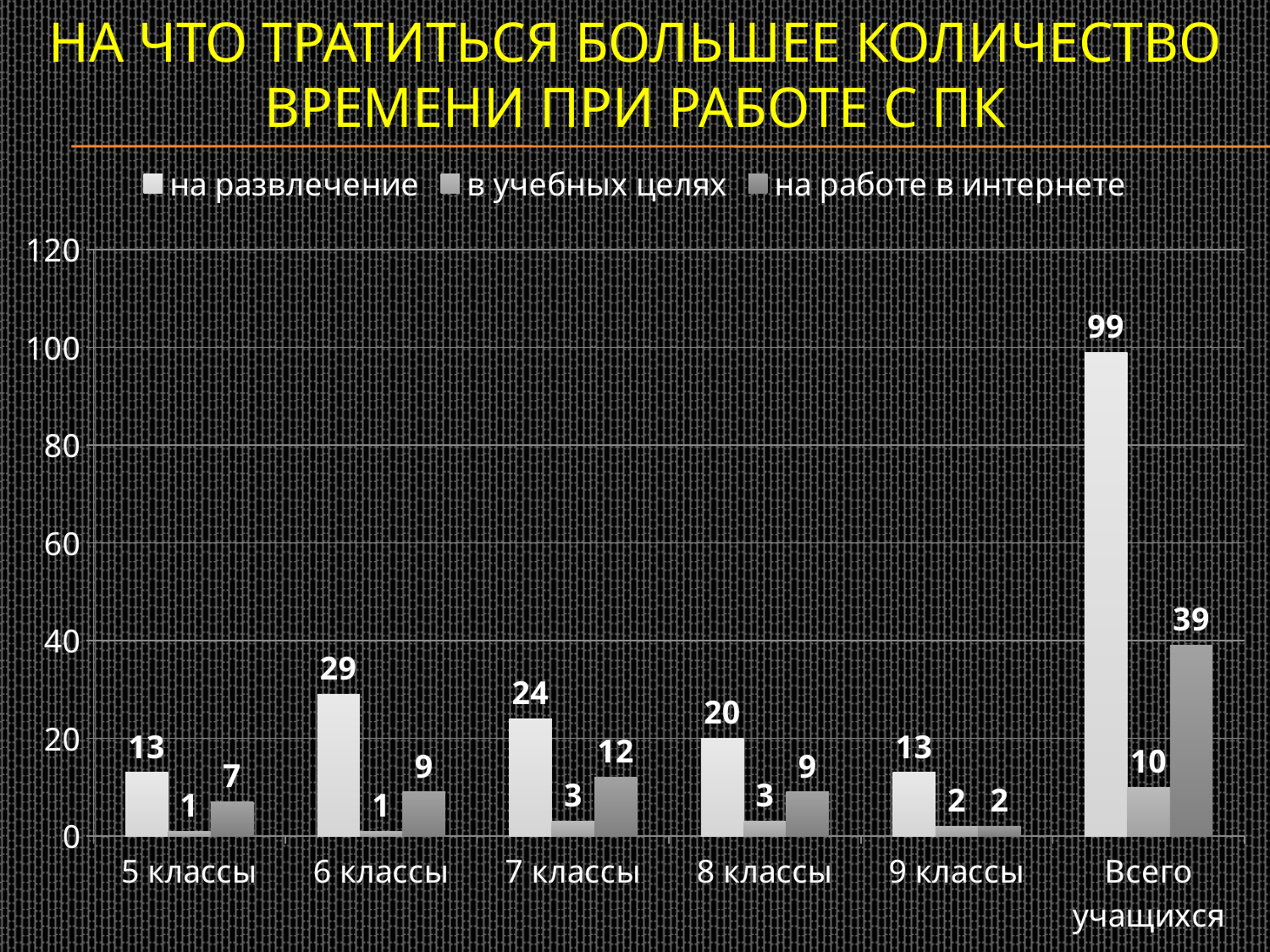
What is the total of the three values for "5 классы"? 21 What kind of chart is shown on the slide? bar chart How many series does the legend list? 3 What is the difference between the "на развлечение" values for "6 классы" and "7 классы"? 5 What is the value for "на работе в интернете" in the "Всего учащихся" category? 39 What is the value for "на развлечение" in the "6 классы" category? 29 Among the class categories (5–9 классы), which has the lowest value for "на работе в интернете"? 9 классы Is the value for "на развлечение" in "Всего учащихся" greater or less than 80? greater Which is larger: the "на работе в интернете" value for "7 классы" or for "8 классы"? 7 классы What is the value for "в учебных целях" in the "7 классы" category? 3 Which category has the highest value for "на развлечение"? Всего учащихся How many categories are shown on the x axis? 6